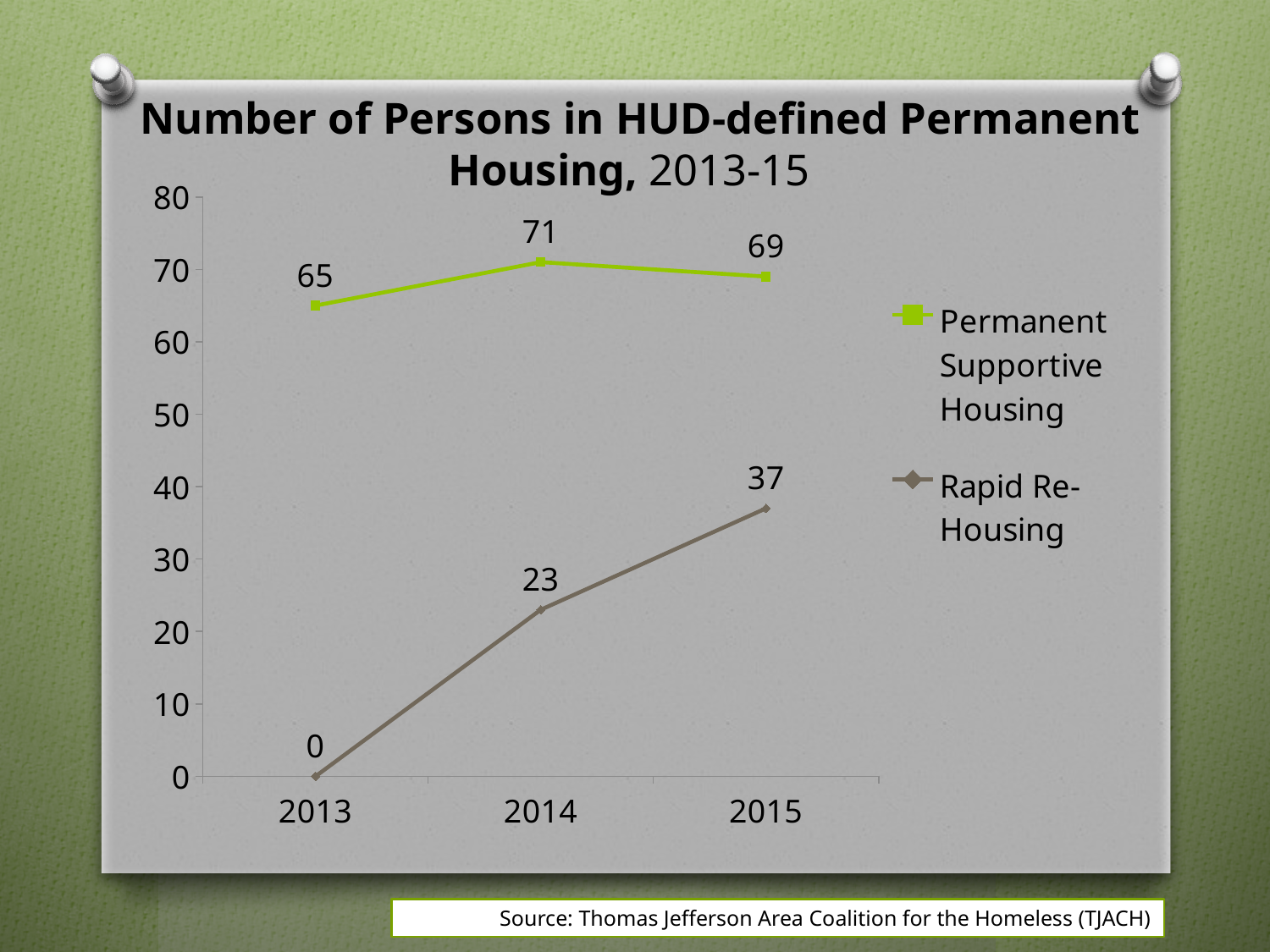
Which series has the larger value in 2014, Permanent Supportive Housing or Rapid Re-Housing? Permanent Supportive Housing In which year is the Rapid Re-Housing value lowest? 2013 How many years are shown on the x axis? 3 Is the value for Rapid Re-Housing in 2014 greater or less than 30? less How many series does the legend list? 2 What is the difference between the Permanent Supportive Housing and Rapid Re-Housing values in 2015? 32 What is the value for Rapid Re-Housing in 2013? 0 What is the value for Permanent Supportive Housing in 2014? 71 What is the value for Rapid Re-Housing in 2015? 37 Does the Rapid Re-Housing series rise or fall from 2013 to 2015? rise In which year is the Permanent Supportive Housing value highest? 2014 What kind of chart is shown on the slide? line chart